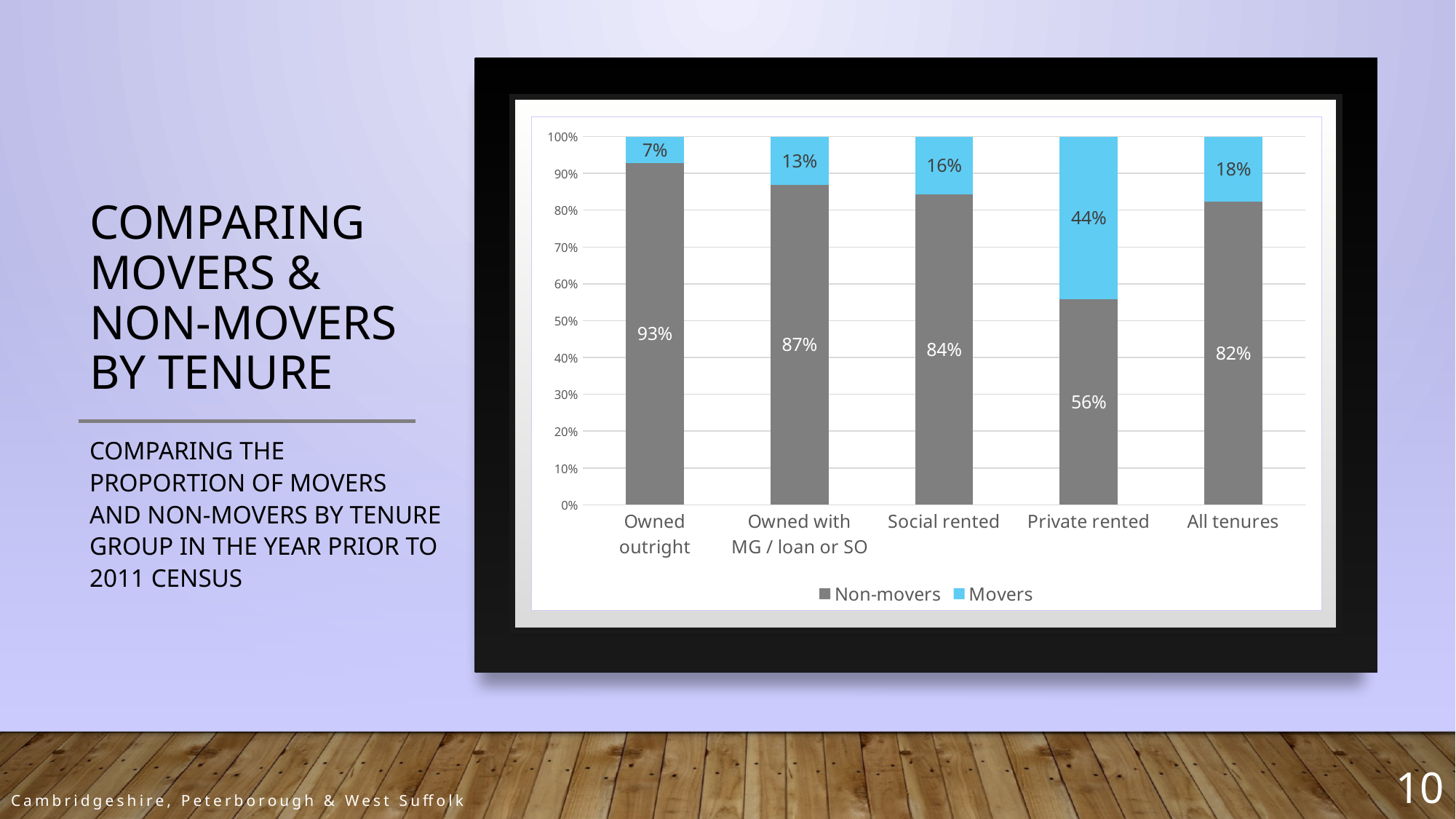
What is the Movers value for Social rented? 16% Which tenure group has the highest proportion of Movers? Private rented What percentage of Private rented households were Movers? 44% Which tenure group has the lowest proportion of Movers? Owned outright What is the Non-movers value for All tenures? 82% How many tenure groups are shown on the x axis? 5 Which colour represents Movers in the chart? Blue What is the difference between the Non-movers percentage for Owned outright and for Private rented? 37% Which has a larger Movers share, Owned with MG / loan or SO or Social rented? Social rented What kind of chart is shown on the slide? Stacked bar chart How many series does the legend list? 2 What percentage of Owned outright households were Non-movers? 93%